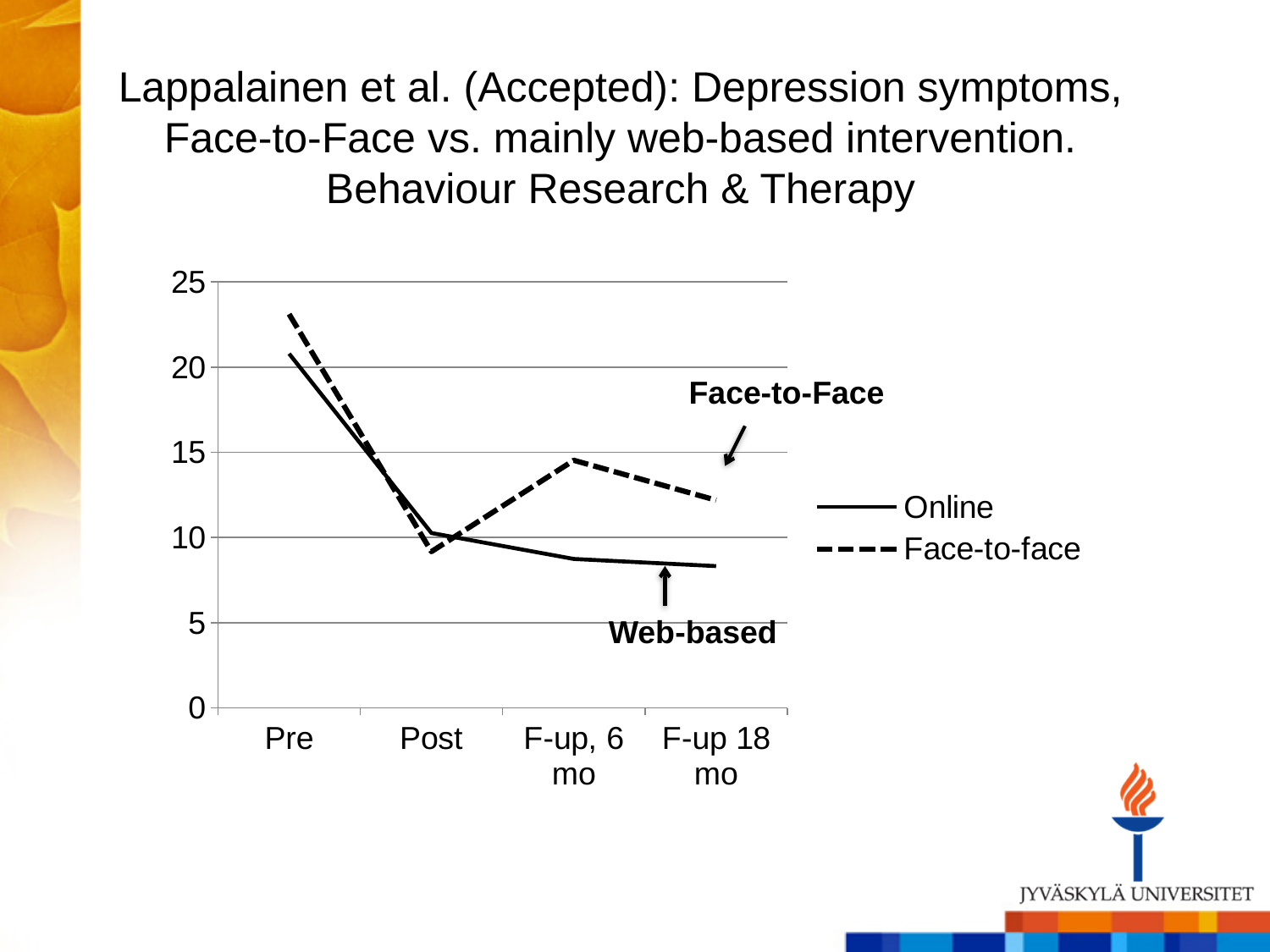
Is the Face-to-face value at F-up 18 mo greater or less than 10? greater Does the Online series rise or fall from Pre to F-up 18 mo? Fall Is the Face-to-face value at Pre greater or less than 20? greater How many time points are shown on the x axis? 4 How many series does the legend list? 2 Which series is drawn with a dashed line? Face-to-face Is the Online value at F-up 18 mo greater or less than 10? less At which time point is the Face-to-face series lowest? Post What are the two entries in the legend? Online and Face-to-face At F-up, 6 mo, which series has the higher value, Online or Face-to-face? Face-to-face What kind of chart is shown on the slide? Line chart